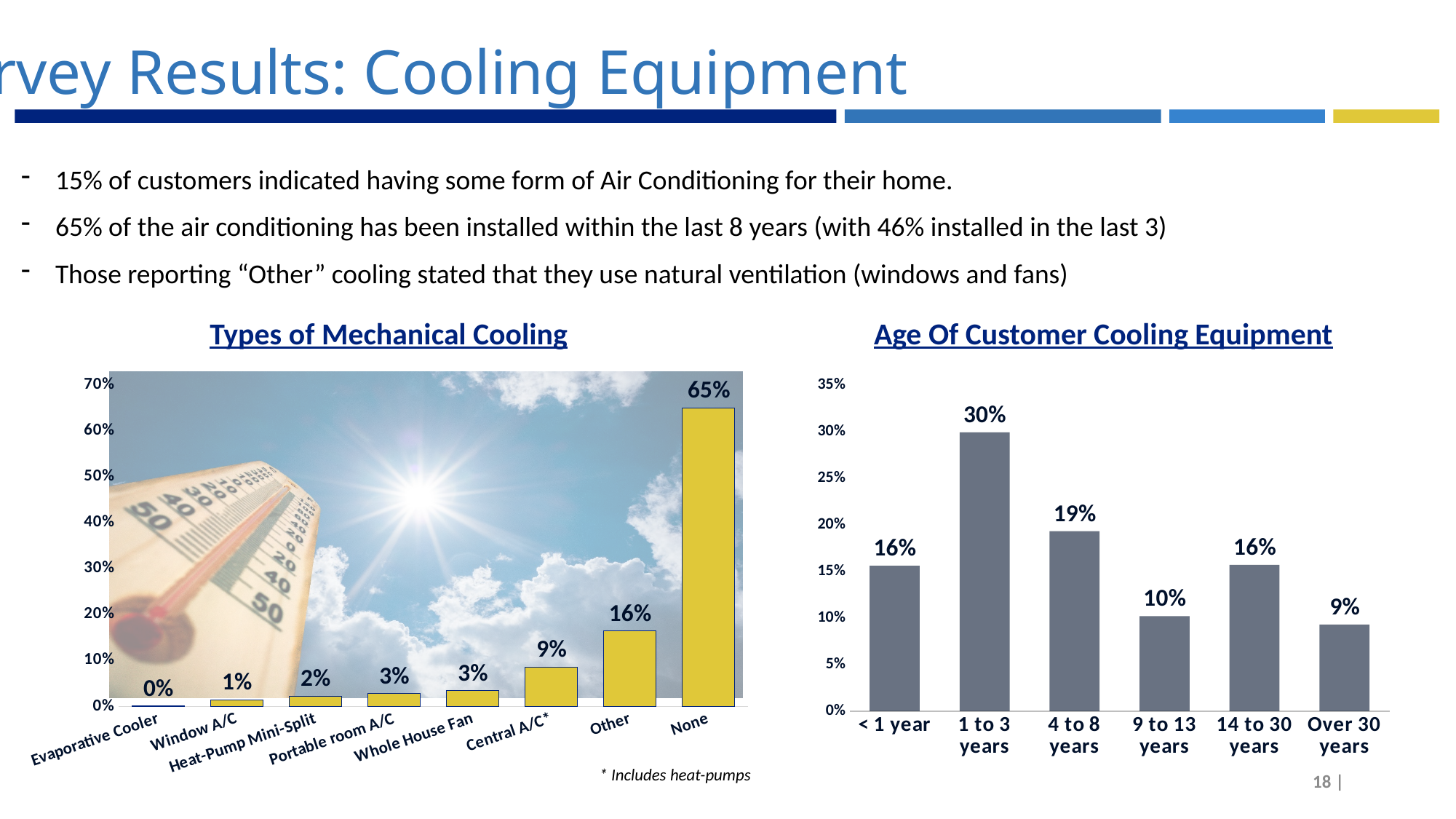
In the 'Types of Mechanical Cooling' chart, what is the difference between the values for None and Other? 49% In the 'Types of Mechanical Cooling' chart, what is the value for Window A/C? 1% In the 'Types of Mechanical Cooling' chart, which category has the highest value? None In the 'Types of Mechanical Cooling' chart, which category has the lowest value? Evaporative Cooler In the 'Age Of Customer Cooling Equipment' chart, which category has the lowest value? Over 30 years In the 'Age Of Customer Cooling Equipment' chart, what is the difference between the values for 1 to 3 years and < 1 year? 14% In the 'Types of Mechanical Cooling' chart, how many categories are shown on the x axis? 8 In the 'Types of Mechanical Cooling' chart, what is the value for Central A/C*? 9% In the 'Age Of Customer Cooling Equipment' chart, which is larger: the value for 9 to 13 years or the value for 14 to 30 years? 14 to 30 years What kind of chart is the 'Age Of Customer Cooling Equipment' chart? Bar chart In the 'Age Of Customer Cooling Equipment' chart, what is the value for 4 to 8 years? 19% In the 'Age Of Customer Cooling Equipment' chart, which category has the highest value? 1 to 3 years